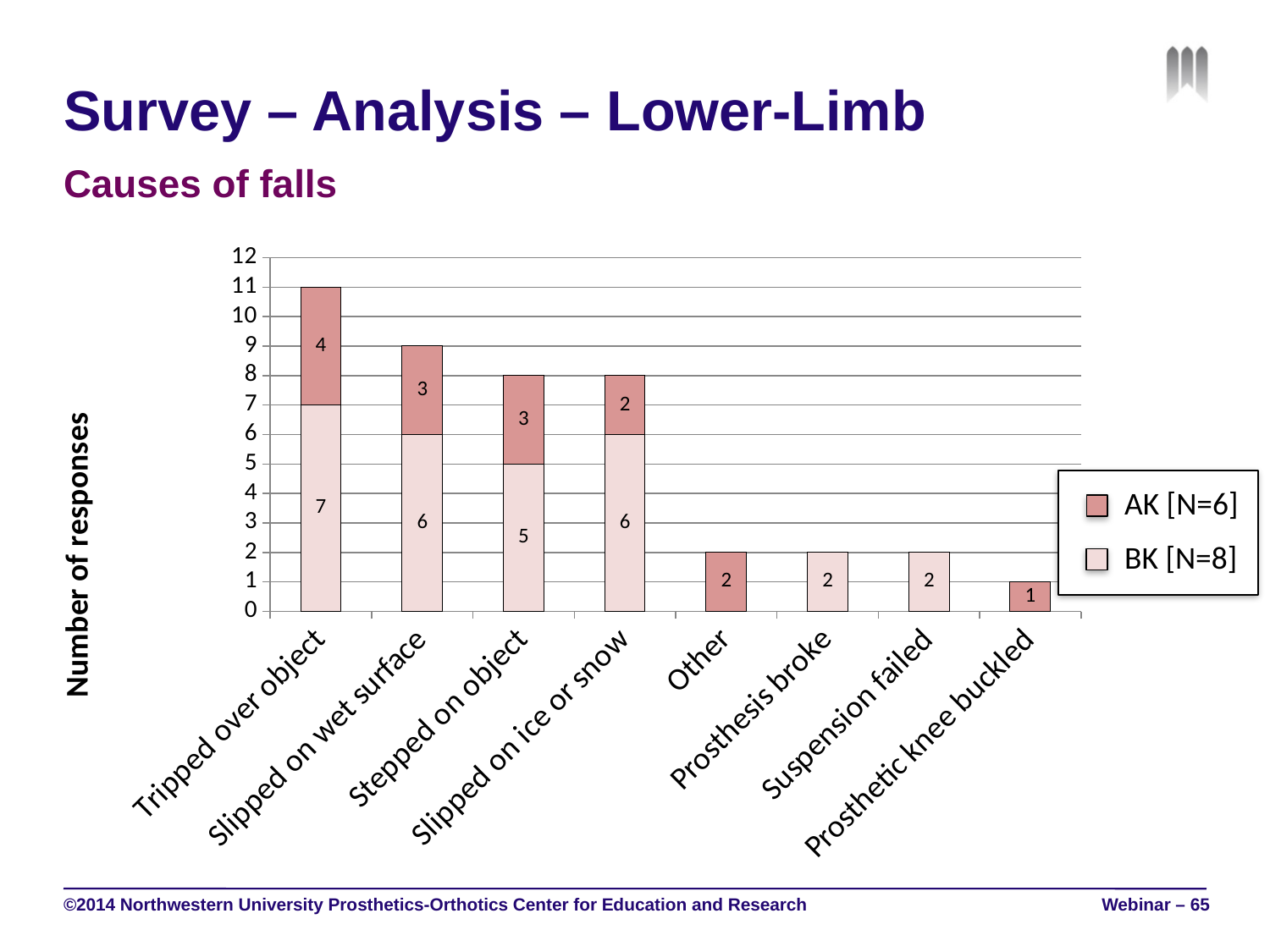
What is the total number of responses for Slipped on wet surface (AK and BK combined)? 9 Which cause of falls has the lowest total number of responses? Prosthetic knee buckled What is the AK [N=6] value for Prosthetic knee buckled? 1 What is the BK [N=8] value for Tripped over object? 7 What is the AK [N=6] value for Slipped on wet surface? 3 How many causes of falls are shown on the x axis? 8 How many series does the legend list? 2 Which is larger, the AK [N=6] value for Tripped over object or the AK [N=6] value for Stepped on object? Tripped over object What is the AK [N=6] value for Slipped on ice or snow? 2 Which cause of falls has the highest total number of responses? Tripped over object What is the difference between the BK [N=8] values for Tripped over object and Stepped on object? 2 What is the total number of responses for Tripped over object (AK and BK combined)? 11